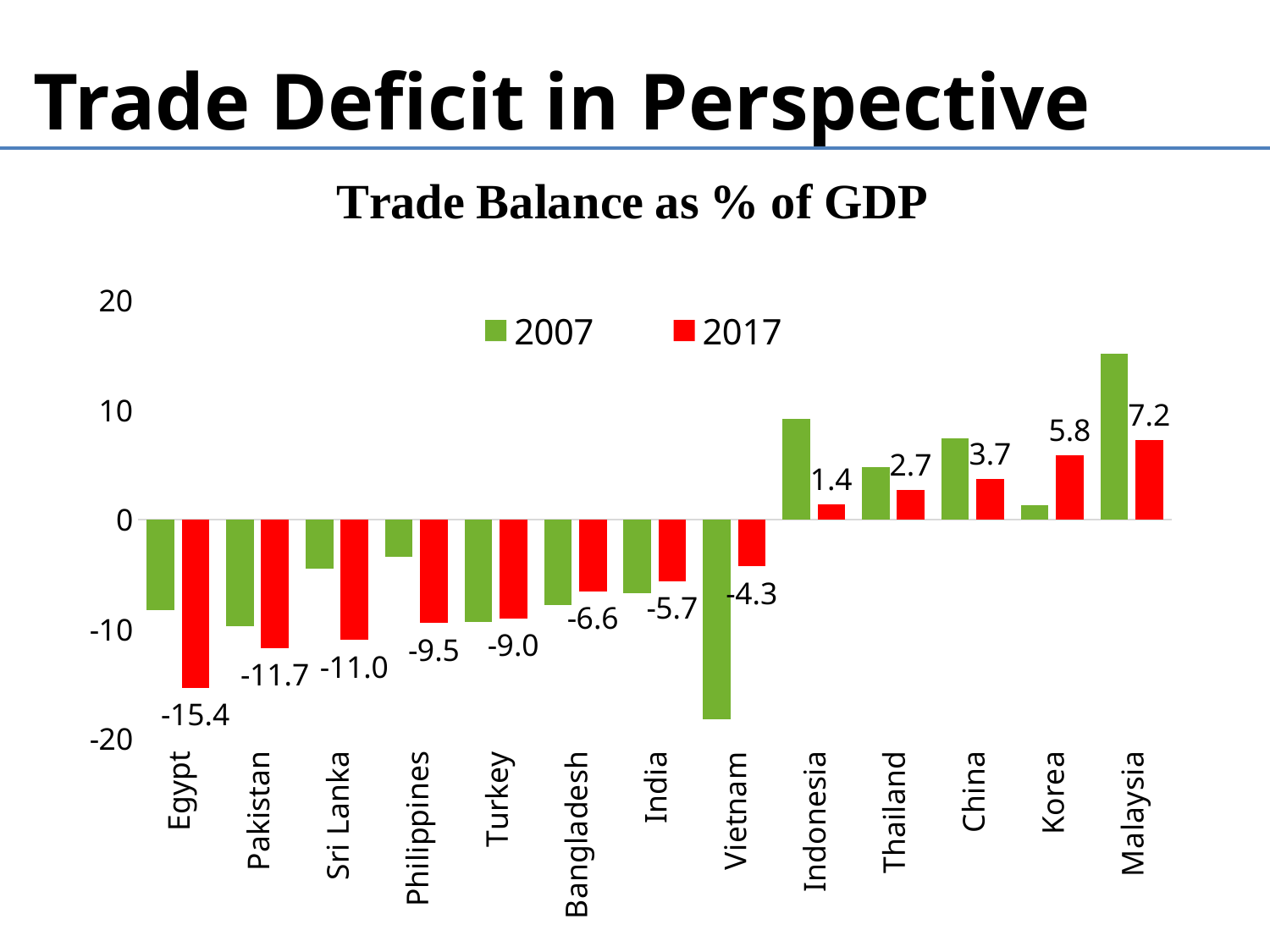
How many countries are shown on the x axis? 13 Is the 2007 value for Malaysia greater or less than 10? greater What is the 2017 value for Bangladesh? -6.6 Which has a higher 2017 value, Thailand or Indonesia? Thailand Which country has the lowest 2017 trade balance as % of GDP? Egypt What is the 2017 value for Malaysia? 7.2 What is the 2017 trade balance as % of GDP for Egypt? -15.4 What type of chart is shown? Bar chart What is the difference between the 2017 values for Korea and China? 2.1 Which country has the highest 2017 trade balance as % of GDP? Malaysia How many series does the legend list? 2 Is the 2007 value for Vietnam greater or less than -10? less